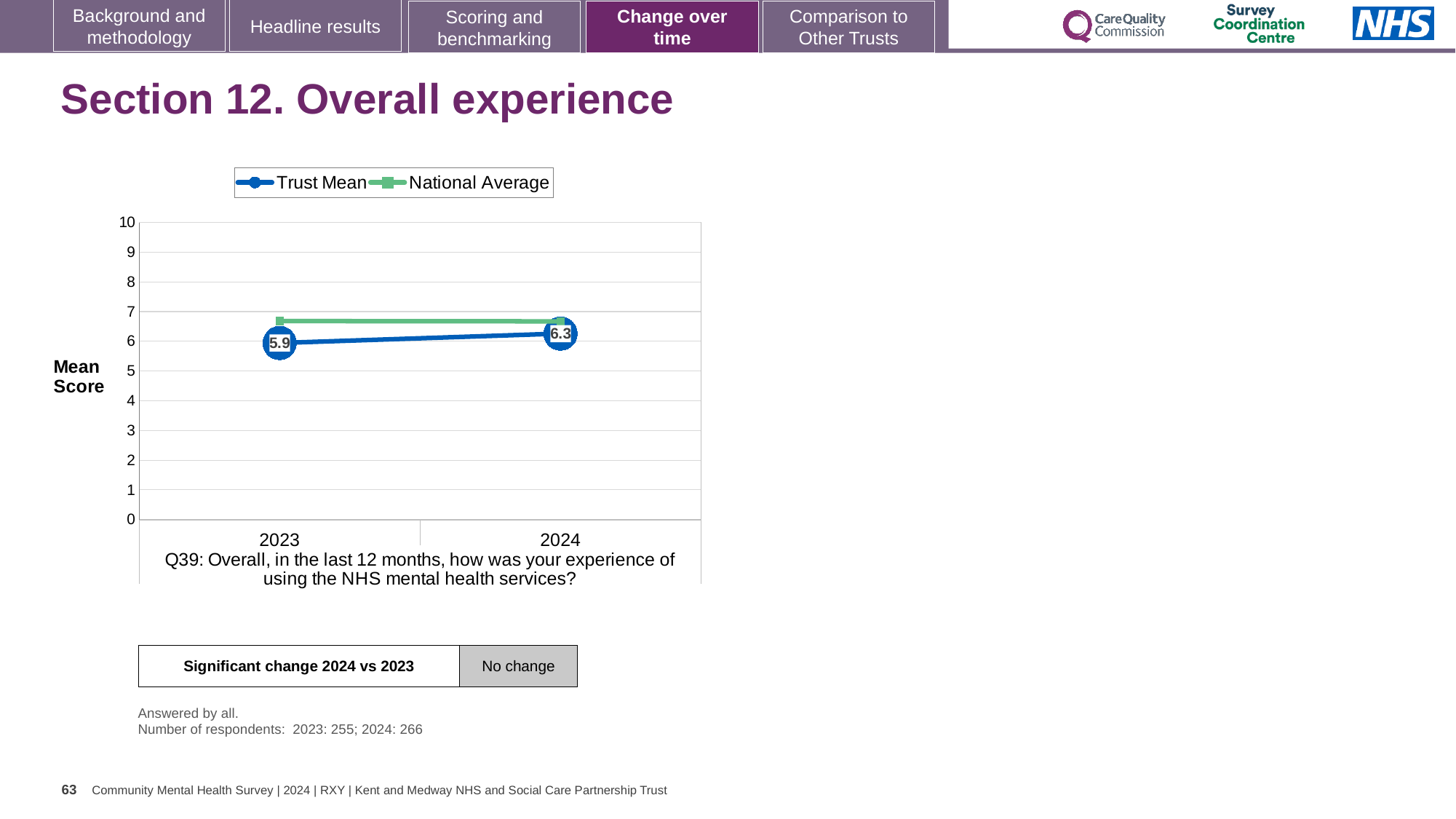
How many series does the chart legend list? 2 What kind of chart is shown on the slide? line chart In 2023, which is larger, the Trust Mean or the National Average? National Average In which year is the Trust Mean lowest? 2023 How many years are plotted on the x axis of the chart? 2 What is the label on the y axis of the chart? Mean Score Does the Trust Mean rise or fall from 2023 to 2024? rise What is the difference between the Trust Mean in 2024 and in 2023? 0.4 Which year has the higher Trust Mean, 2023 or 2024? 2024 What is the Trust Mean value for 2023? 5.9 Is the National Average value for 2023 greater or less than 6? greater What is the Trust Mean value for 2024? 6.3